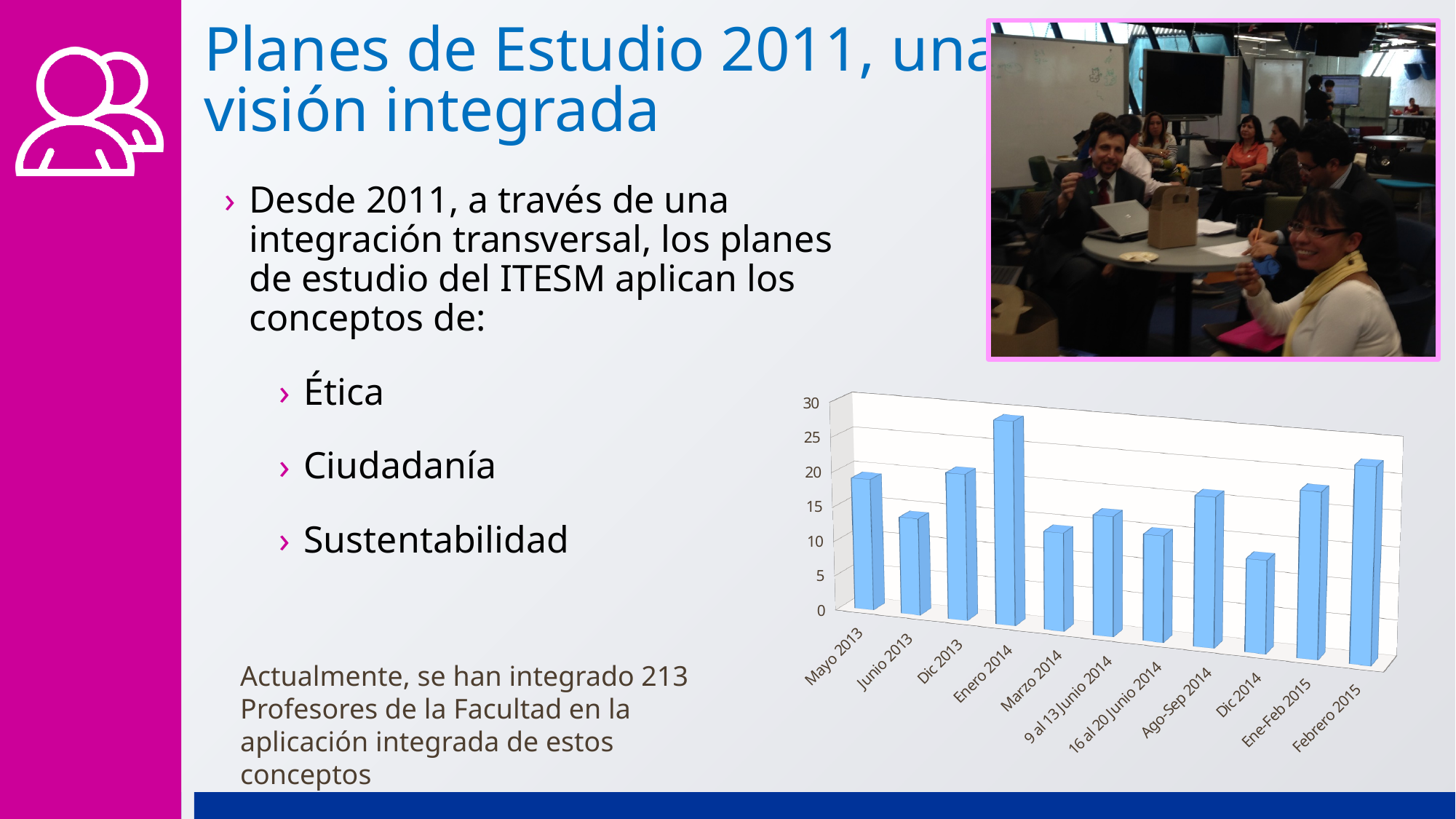
Is the value for Enero 2014 greater or less than 25? greater Is the value for Marzo 2014 greater or less than 15? less Which category has the lowest bar in the chart? Dic 2014 Is the value for Febrero 2015 greater or less than 15? greater How many categories are shown along the x axis of the chart? 11 Which is larger, the value for Dic 2013 or the value for Junio 2013? Dic 2013 What kind of chart is shown on the slide? bar chart Which category has the highest bar in the chart? Enero 2014 Which is larger, the value for Ago-Sep 2014 or the value for Dic 2014? Ago-Sep 2014 What colour are the bars in the chart? blue